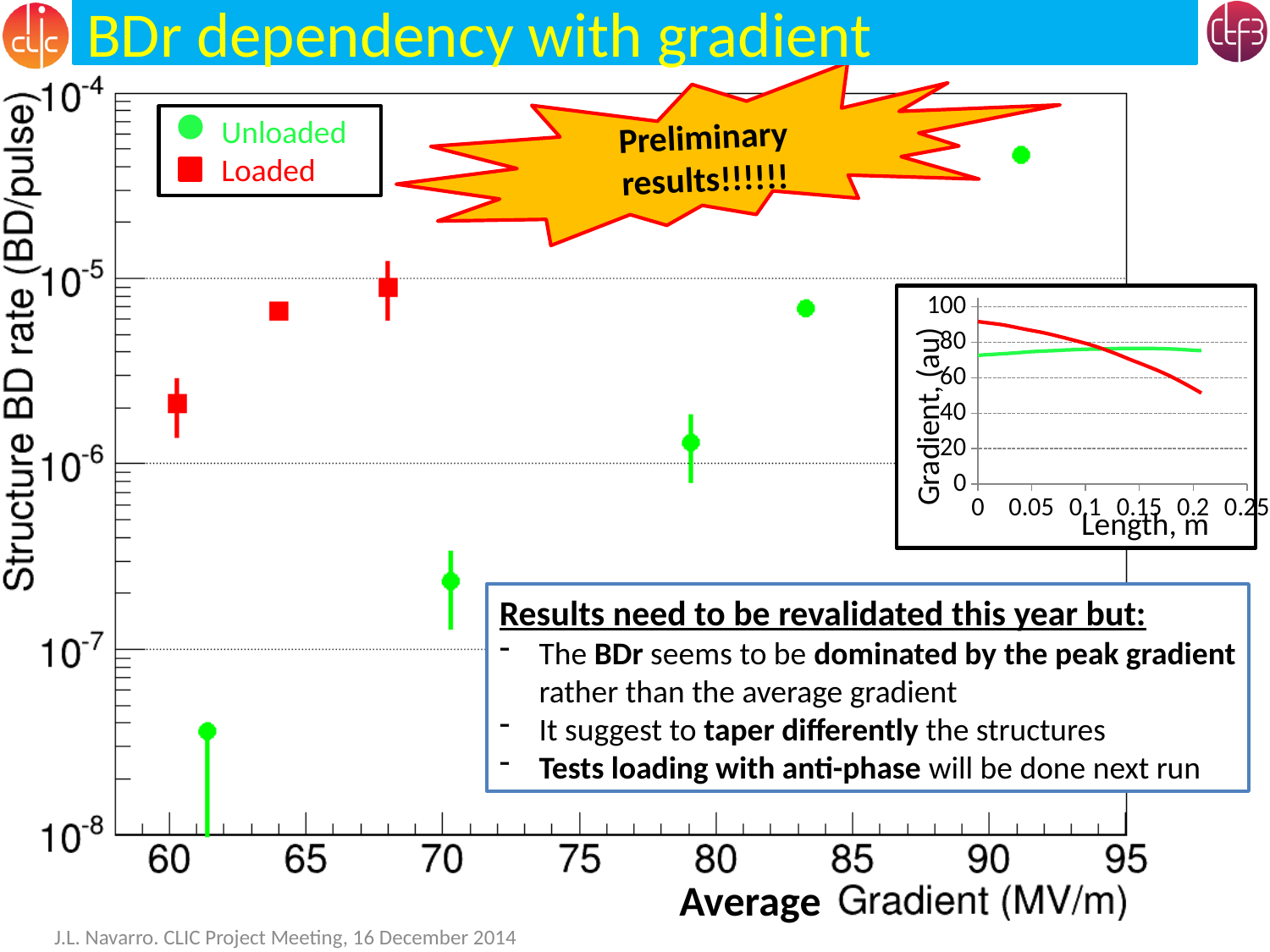
In the main chart, is the BD rate of the Loaded point near 60 MV/m greater or less than 10^-6? greater In the main chart, how many Unloaded data points are plotted? 5 In the main chart, how many Loaded data points are plotted? 3 In the main chart, what are the two legend entries? Unloaded and Loaded What kind of chart is the inset chart of Gradient versus Length? line chart In the main chart, is the BD rate of the highest-gradient Unloaded point (near 91 MV/m) greater or less than 10^-5? greater In the inset chart of Gradient versus Length, does the red line rise or fall as length increases? fall In the main chart, does the Unloaded BD rate rise or fall as the average gradient increases? rise In the main chart, which has the higher BD rate: the Unloaded point near 91 MV/m or the Loaded point near 68 MV/m? Unloaded point near 91 MV/m In the main chart, how many series does the legend list? 2 In the main chart, which series contains the point with the highest BD rate? Unloaded In the main chart, is the BD rate of the lowest-gradient Unloaded point (near 61 MV/m) greater or less than 10^-7? less